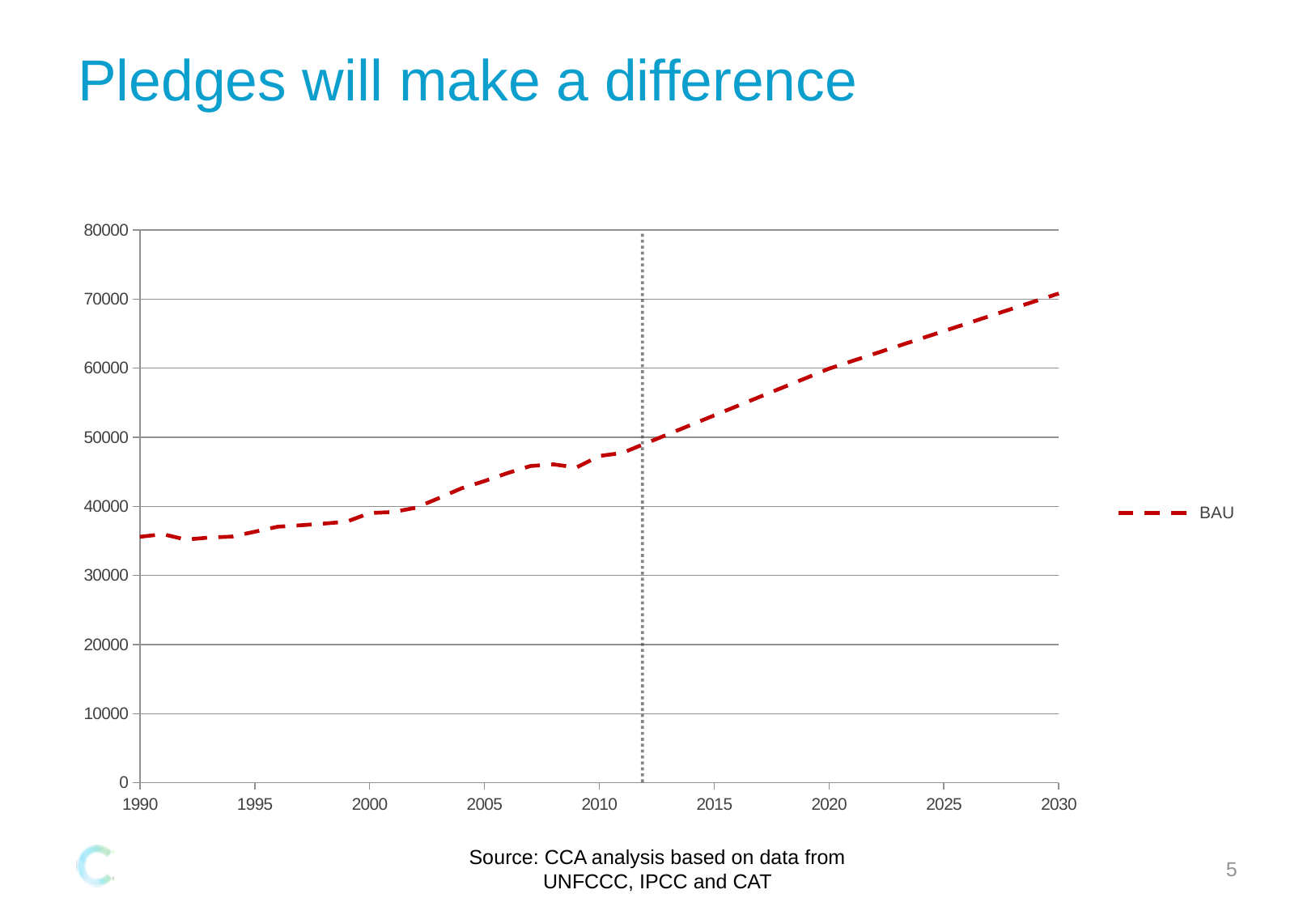
How many series does the legend list? 1 What is the name of the series shown in the legend? BAU Is the BAU value for 2020 greater or less than 50000? greater In which year on the x axis does the BAU line reach its highest value? 2030 Does the BAU line generally rise or fall from 1990 to 2030? rise Is the BAU value for 2010 greater or less than 50000? less What is the highest value shown on the y axis? 80000 Which is larger, the BAU value in 2000 or the BAU value in 2025? 2025 Is the BAU value for 2030 greater or less than 60000? greater What kind of chart is shown on the slide? line chart